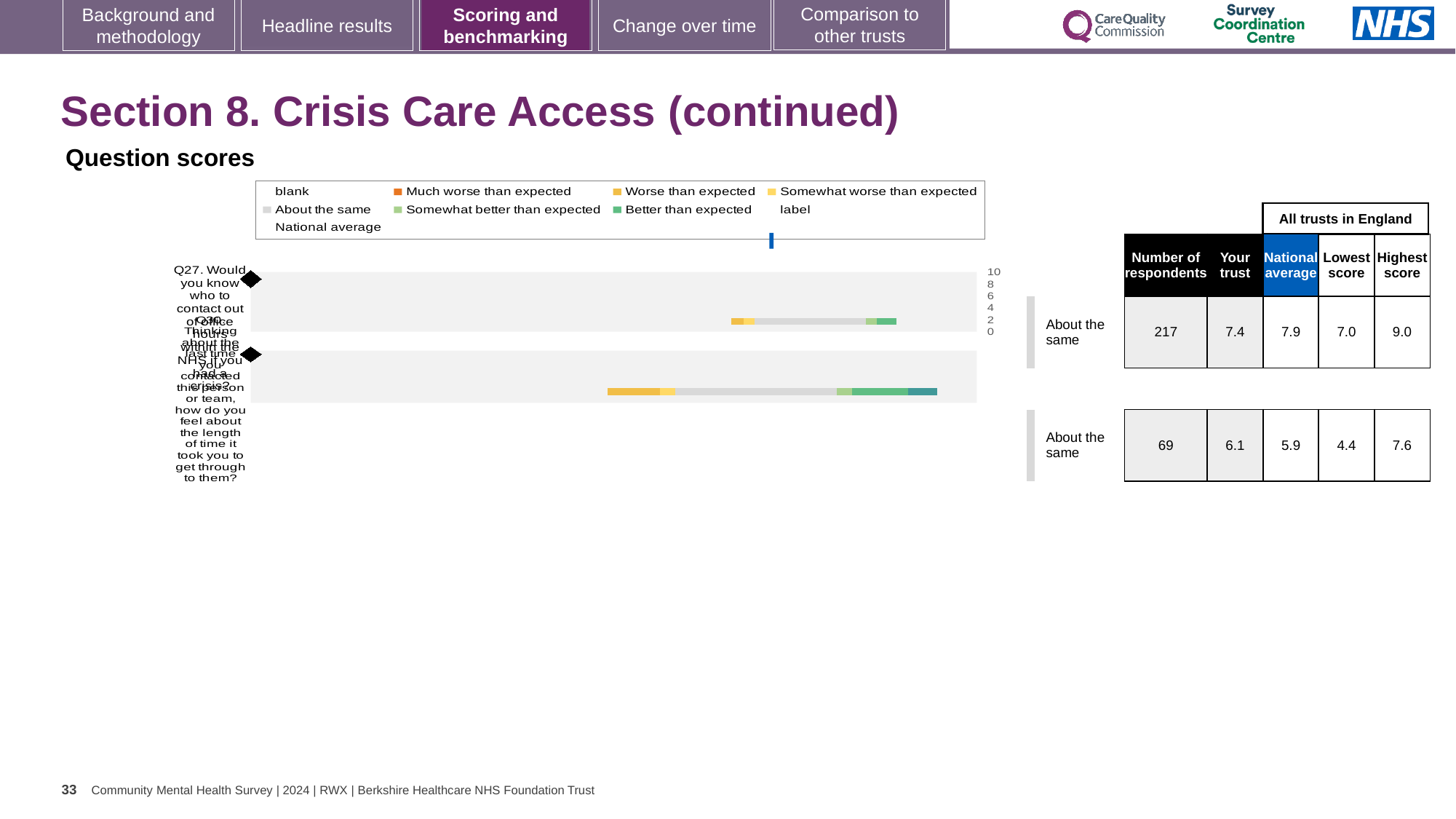
What is the heading above the chart on this slide? Question scores What is the difference between the highest score and the lowest score for Q30? 3.2 What is the 'Your trust' score for Q27 (Would you know who to contact out of office hours within the NHS if you had a crisis?)? 7.4 By how much does the national average exceed the 'Your trust' score for Q27? 0.5 What is the national average score for Q30 (how do you feel about the length of time it took you to get through to them)? 5.9 Which question has the higher 'Your trust' score, Q27 or Q30? Q27 How many questions are plotted in the question scores chart? 2 How many respondents answered Q27? 217 What is the highest score among all trusts in England for Q27? 9.0 For Q27, which is larger: the 'Your trust' score or the national average? National average What kind of chart is used to show the question scores on this slide? Bar chart How is the trust's result for Q30 categorised compared with what is expected? About the same